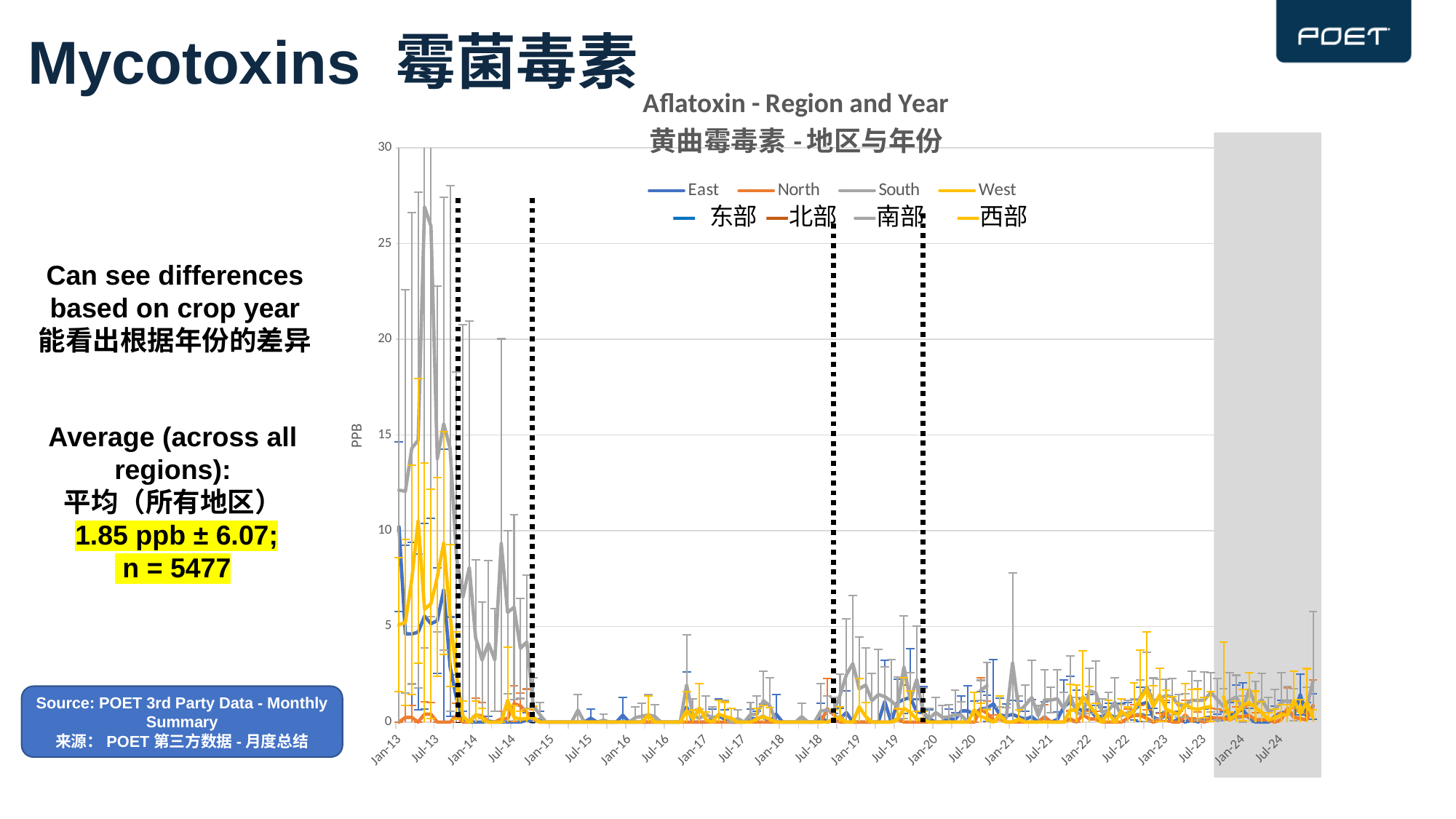
What is the highest tick value shown on the vertical axis? 30 Is the peak value of the West series in 2013 greater or less than 15 PPB? less Do the aflatoxin values generally rise or fall from 2013 to 2015 along the x axis? fall What label is shown on the vertical axis of the chart? PPB Is the peak value of the East series in 2013 greater or less than 5 PPB? greater Around Jan-21, is the South series value greater or less than 5 PPB? less What kind of chart is shown on the slide? Line chart How many series does the legend of the Aflatoxin chart list? 4 Which region's series reaches the highest value on the chart? South Which series has the higher peak in 2013, South or East? South What is the English title of the chart? Aflatoxin - Region and Year